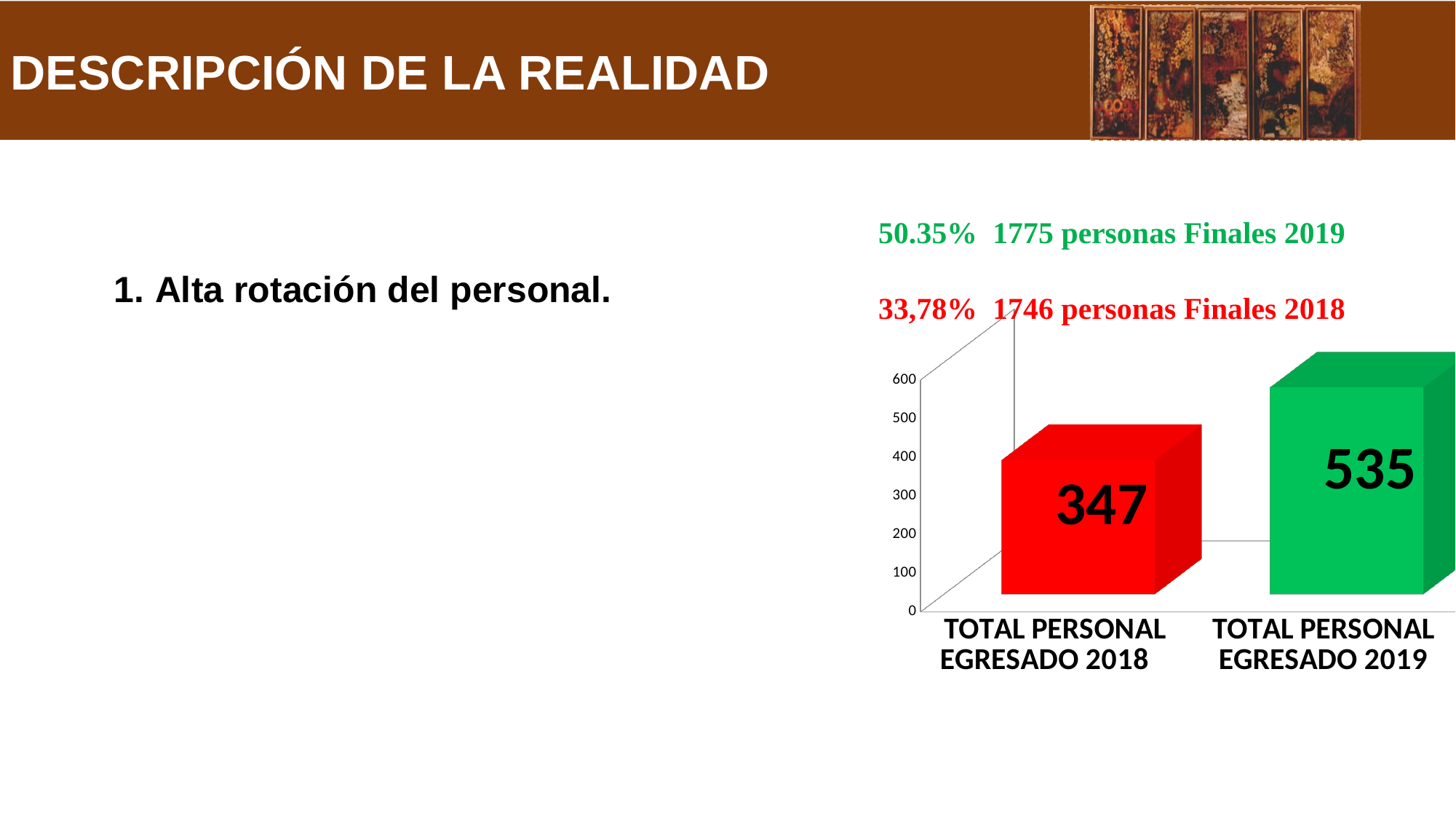
What kind of chart is shown on the slide? bar chart Which is larger, the value for TOTAL PERSONAL EGRESADO 2018 or TOTAL PERSONAL EGRESADO 2019? TOTAL PERSONAL EGRESADO 2019 What is the value for TOTAL PERSONAL EGRESADO 2018? 347 Is the value for TOTAL PERSONAL EGRESADO 2018 greater or less than 400? less Which category has the highest value? TOTAL PERSONAL EGRESADO 2019 What is the difference between the values for TOTAL PERSONAL EGRESADO 2019 and TOTAL PERSONAL EGRESADO 2018? 188 Is the value for TOTAL PERSONAL EGRESADO 2019 greater or less than 500? greater Which category has the lowest value? TOTAL PERSONAL EGRESADO 2018 What colour is the bar for TOTAL PERSONAL EGRESADO 2019? green How many categories are shown in the chart? 2 What is the value for TOTAL PERSONAL EGRESADO 2019? 535 Do the values rise or fall from 2018 to 2019 along the x axis? rise